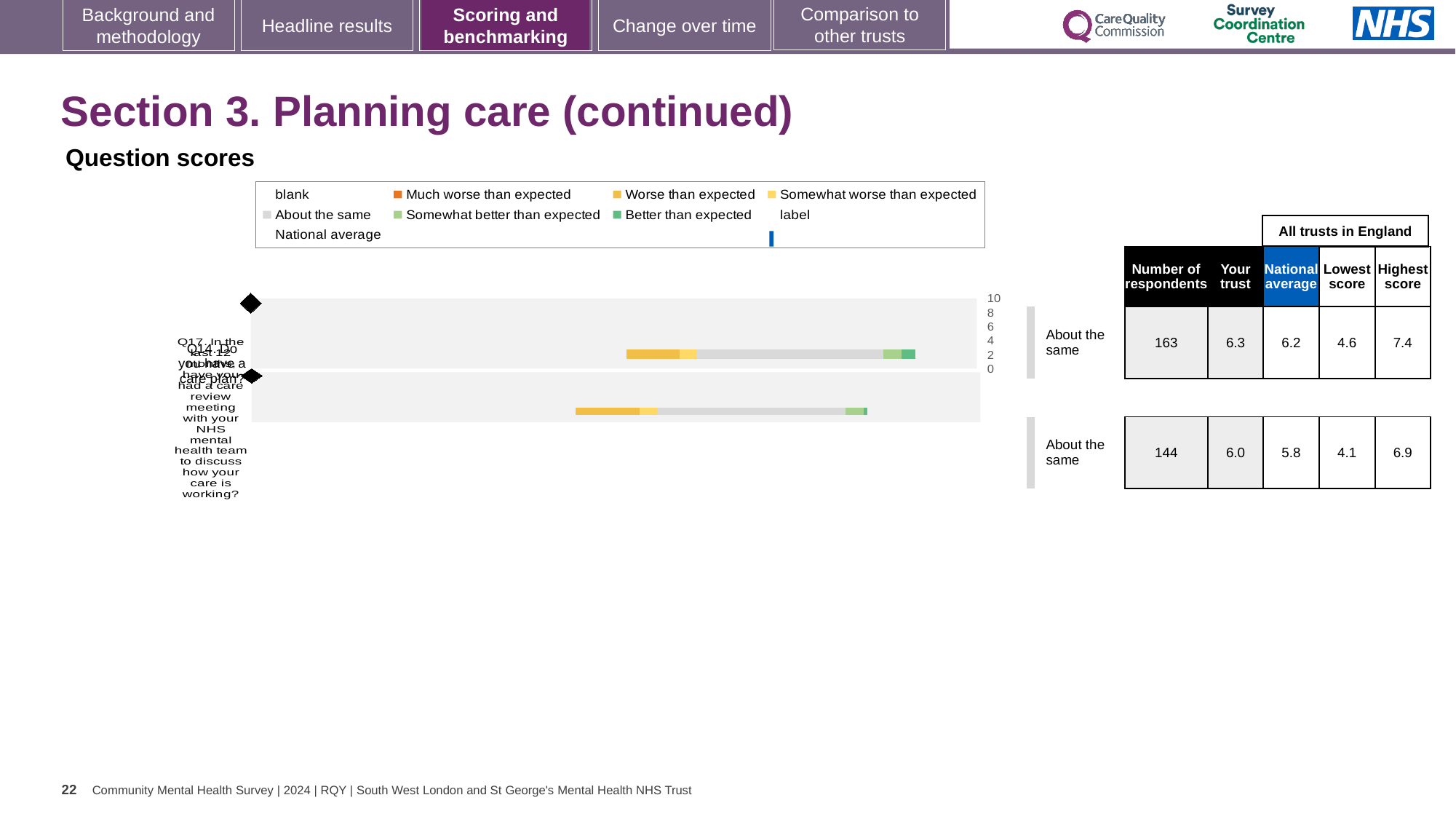
Which question had more respondents, Q14 or Q17? Q14 How many question bars are plotted in the chart? 2 What is the national average score for Q17 (care review meeting) in the table beside the chart? 5.8 What kind of chart is shown under 'Question scores'? bar chart How many respondents answered Q14 according to the table beside the chart? 163 What is the 'Your trust' score for Q14 (Do you have a care plan?) in the table beside the chart? 6.3 What is the lowest score across all trusts in England for Q14? 4.6 What is the highest tick value shown on the chart's score axis? 10 What is the highest score across all trusts in England for Q17? 6.9 What colour is the legend marker for 'Much worse than expected'? orange Which question has the higher 'Your trust' score, Q14 or Q17? Q14 What is the difference between the 'Your trust' score and the national average for Q14? 0.1